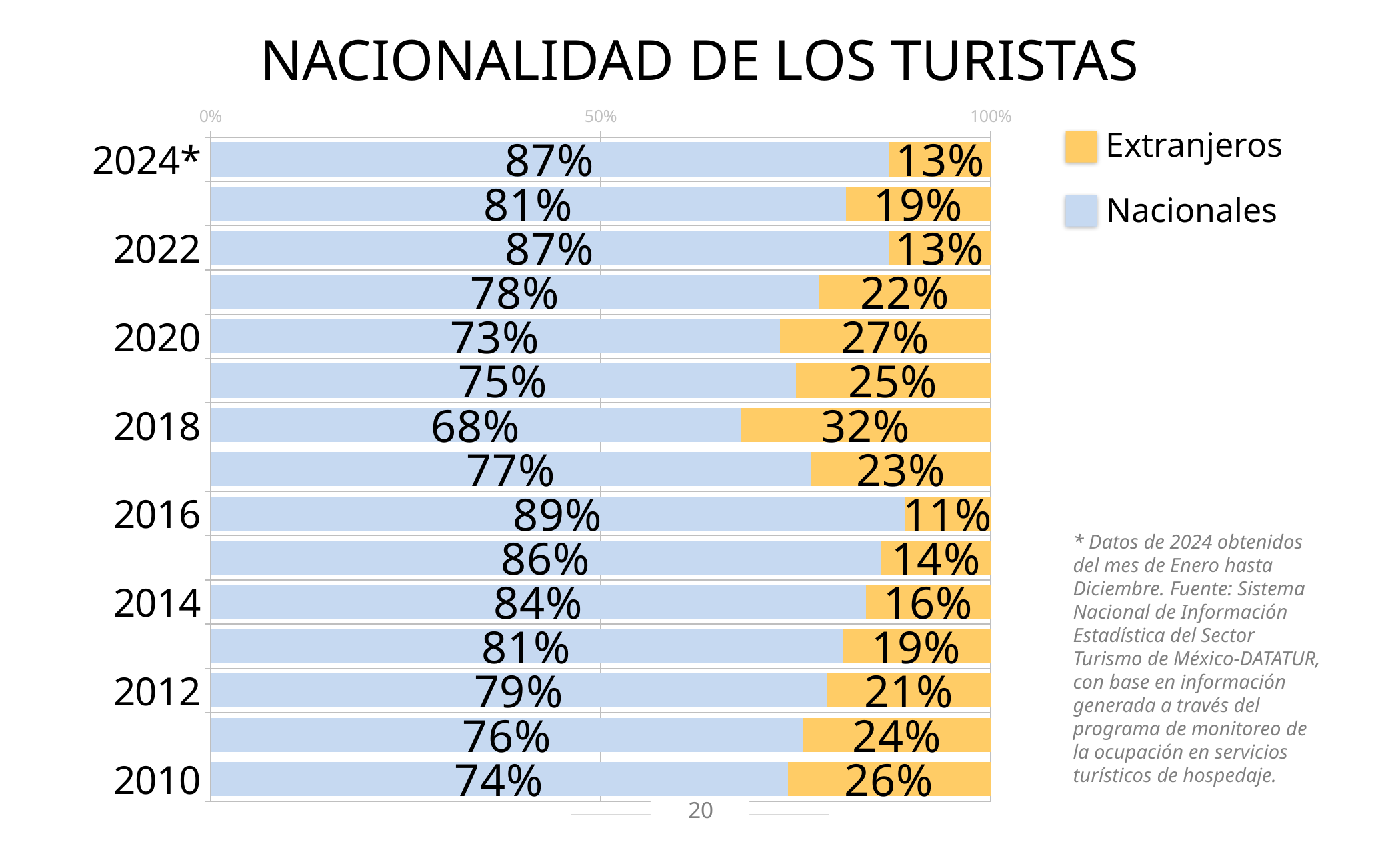
Which year has the lowest Extranjeros share? 2016 Which year has the larger Extranjeros share, 2020 or 2012? 2020 Which year has the highest Extranjeros share? 2018 How many series does the legend list? 2 What kind of chart is shown on the slide? Stacked horizontal bar chart What is the Nacionales share for 2016? 89% What colour represents Extranjeros in the legend? Orange What is the Nacionales share for 2024*? 87% What is the Extranjeros share for 2018? 32% What is the Extranjeros share for 2010? 26% What is the difference between the Nacionales share in 2016 and in 2018? 21 percentage points How many bars are plotted in the chart? 15